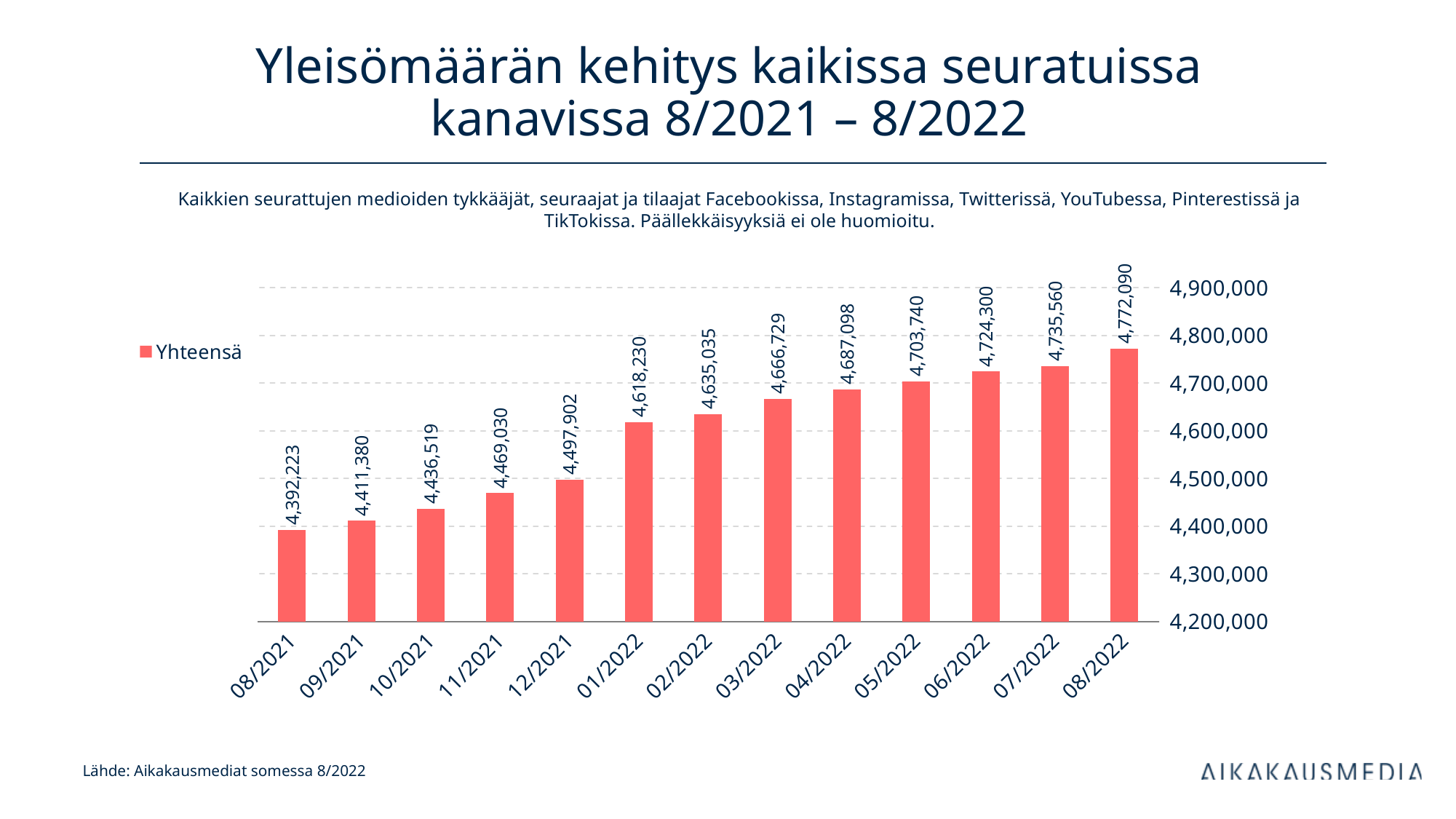
Which month has the lowest value? 08/2021 Is the value for 05/2022 greater or less than 4,600,000? greater How many months are shown on the x axis? 13 Do the values rise or fall from 08/2021 to 08/2022? rise What is the value for 01/2022? 4,618,230 How many series does the legend list? 1 Which is larger, the value for 03/2022 or the value for 11/2021? 03/2022 What is the difference between the values for 08/2022 and 08/2021? 379,867 Which month has the highest value? 08/2022 What is the value for 08/2022? 4,772,090 What is the value for 08/2021? 4,392,223 What is the difference between the values for 01/2022 and 12/2021? 120,328